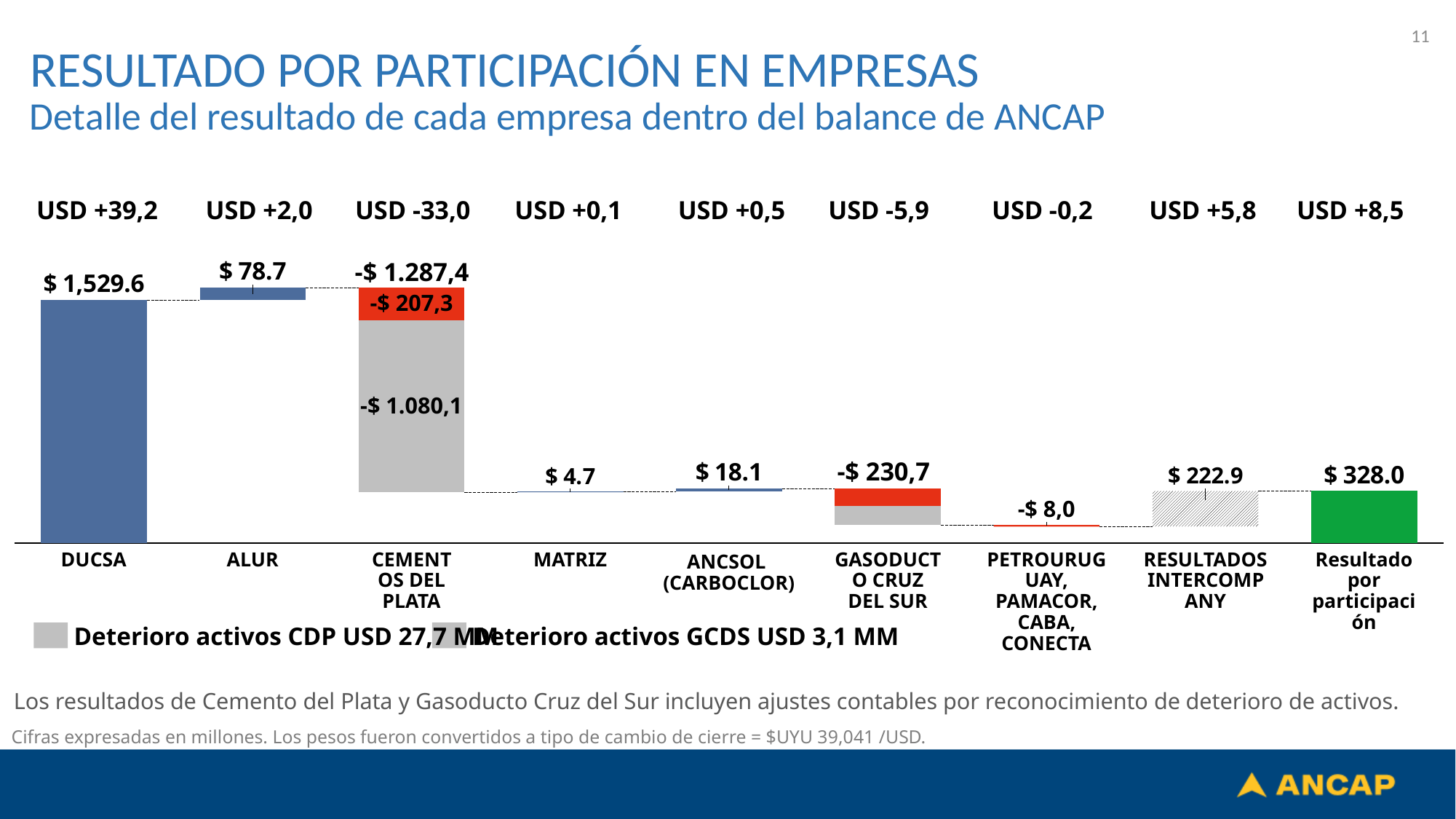
What USD amount is shown above the DUCSA bar? USD +39,2 What is the difference between the values for DUCSA and ALUR? $ 1,450.9 What is the value shown for GASODUCTO CRUZ DEL SUR? -$ 230,7 What is the value shown for ALUR? $ 78.7 What is the total value shown above the CEMENTOS DEL PLATA bar? -$ 1.287,4 Which company has the highest positive result in the chart? DUCSA What is the value shown for DUCSA? $ 1,529.6 What is the final value shown for Resultado por participación? $ 328.0 How many categories are shown along the x axis of the chart? 9 Which is larger, the value for ALUR or the value for ANCSOL (CARBOCLOR)? ALUR Which company has the lowest (most negative) result in the chart? CEMENTOS DEL PLATA What is the value shown for ANCSOL (CARBOCLOR)? $ 18.1